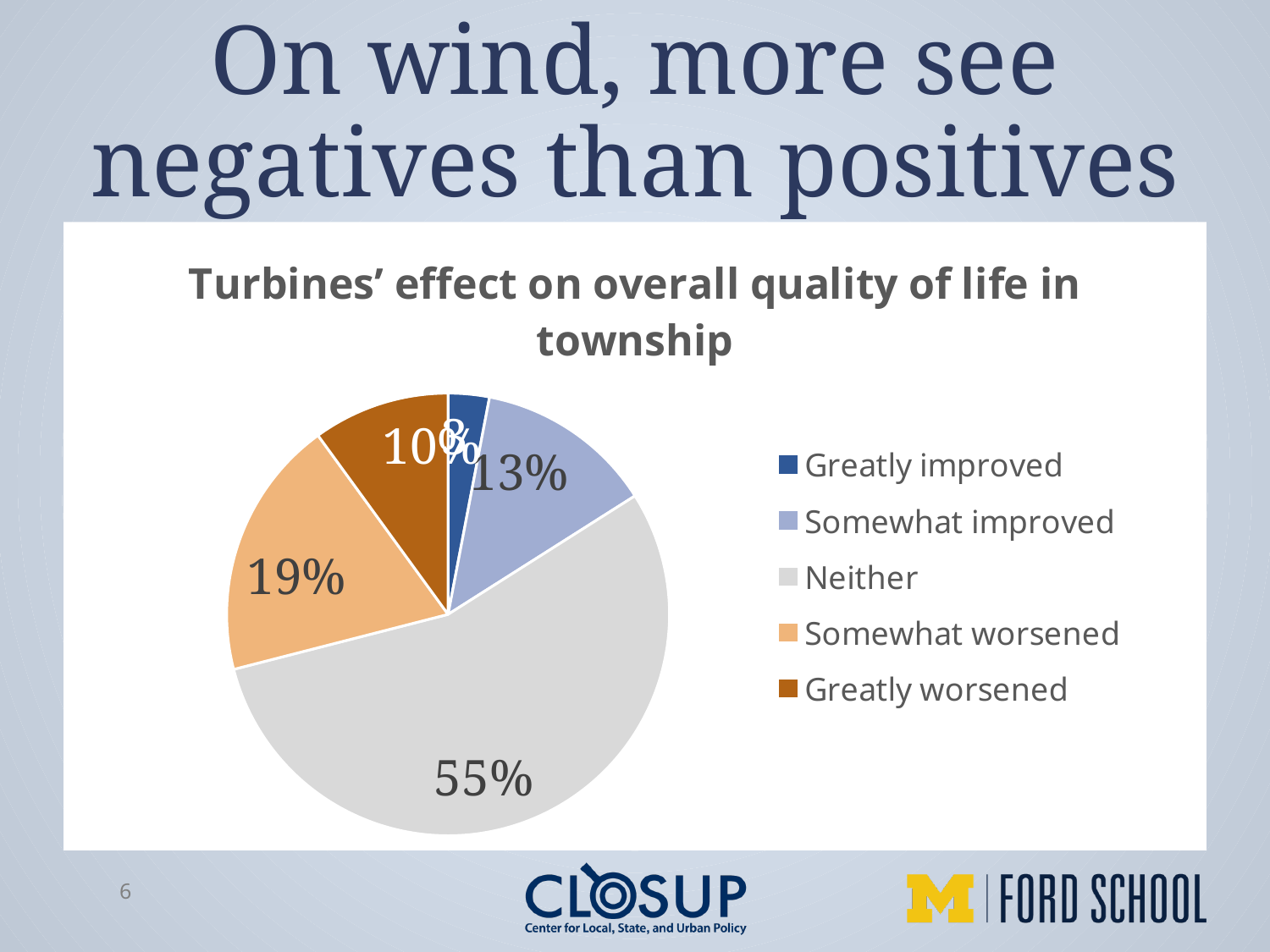
Which is larger: the share for Somewhat worsened or the share for Somewhat improved? Somewhat worsened How many categories does the legend list? 5 Which category has the largest slice of the pie? Neither What is the title of the chart? Turbines' effect on overall quality of life in township What kind of chart is shown on the slide? Pie chart How many percentage points larger is the Neither slice than the Somewhat worsened slice? 36 What percentage of respondents said quality of life was somewhat improved? 13% What percentage of respondents said quality of life was greatly worsened? 10% What share of respondents said turbines had neither improved nor worsened quality of life? 55% What is the difference in percentage points between Somewhat worsened and Somewhat improved? 6 What percentage of respondents said quality of life was somewhat worsened? 19% Which category has the smallest slice of the pie? Greatly improved